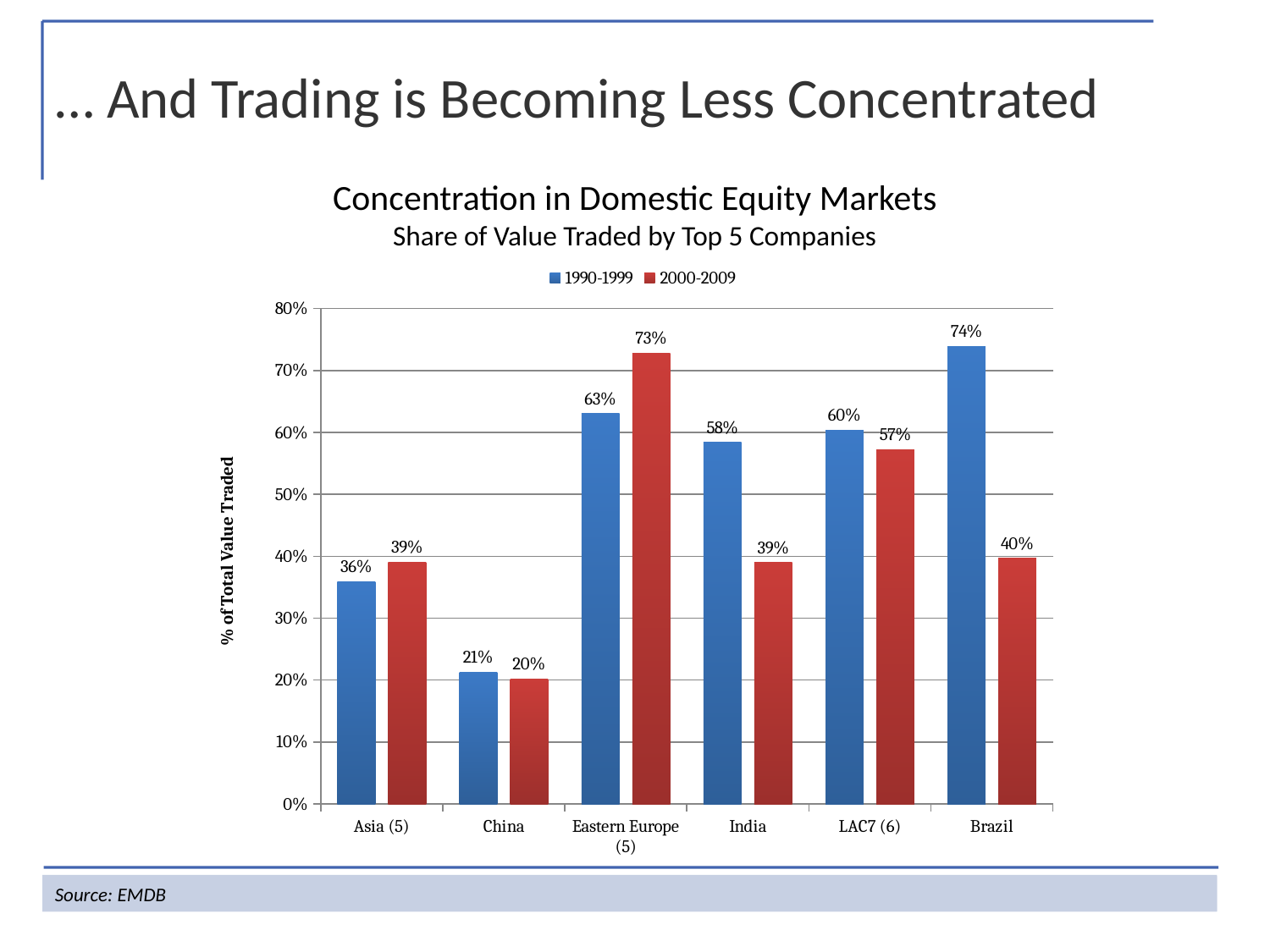
What is the difference between the 2000-2009 and 1990-1999 values for Asia (5)? 3% Which category has the lowest value in the 2000-2009 series? China What kind of chart is shown on the slide? Bar chart How many categories are shown on the x axis? 6 How many series does the legend list? 2 Which category has the highest value in the 1990-1999 series? Brazil What is the label of the y axis? % of Total Value Traded What is the value for Eastern Europe (5) in the 2000-2009 series? 73% What is the value for China in the 2000-2009 series? 20% What is the value for Brazil in the 1990-1999 series? 74% Which is larger for India: the 1990-1999 value or the 2000-2009 value? 1990-1999 What is the difference between the 1990-1999 and 2000-2009 values for Brazil? 34%